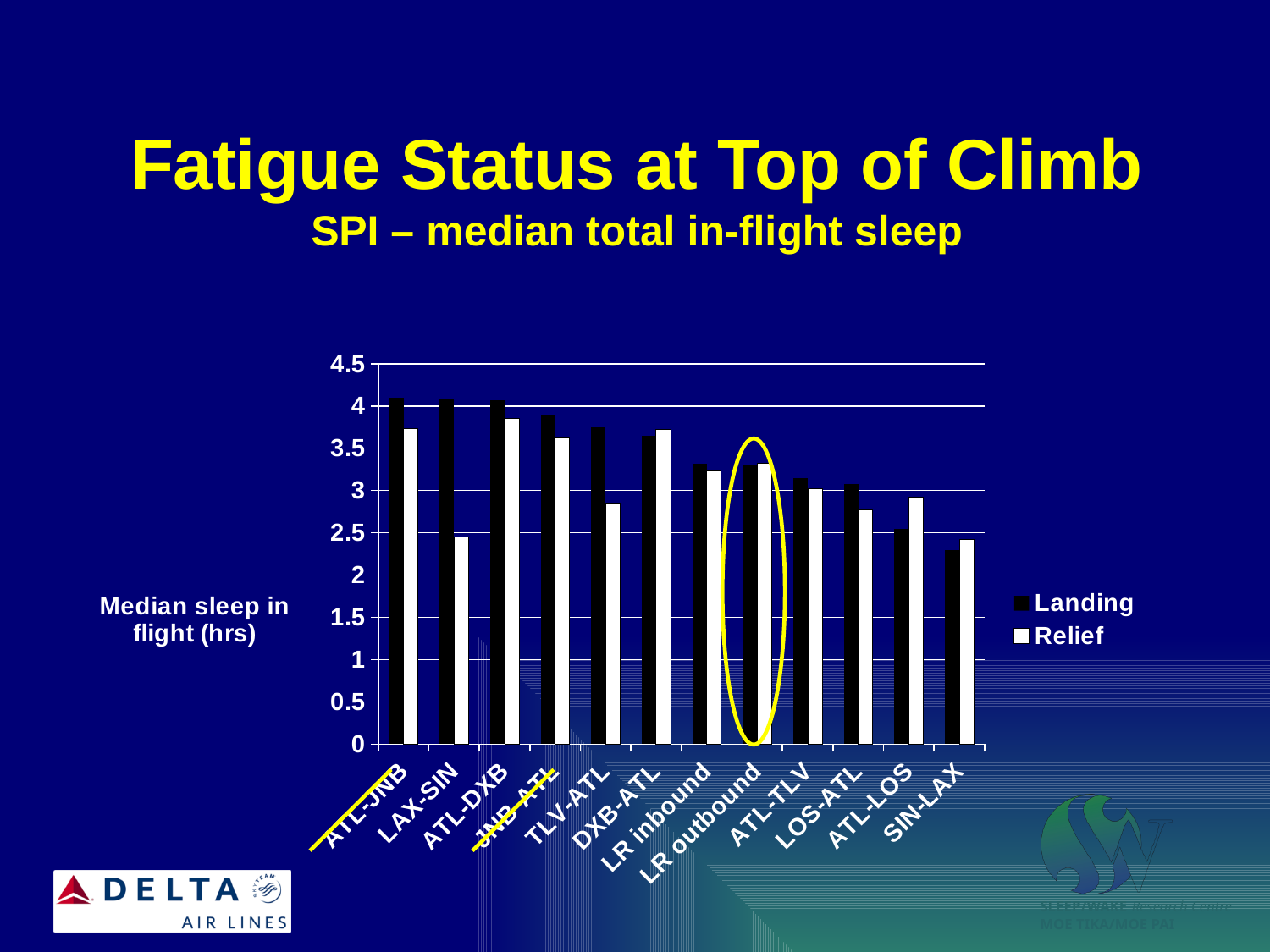
Do the Landing values generally rise or fall from left to right across the x axis? fall What is the label on the y axis of the chart? Median sleep in flight (hrs) Which series is shown with black bars? Landing What kind of chart is shown on the slide? bar chart For LAX-SIN, which is larger, the Landing value or the Relief value? Landing Is the Landing value for ATL-JNB greater or less than 3.5? greater For TLV-ATL, which is larger, the Landing value or the Relief value? Landing Is the Relief value for ATL-DXB greater or less than 3.5? greater Is the Relief value for LAX-SIN greater or less than 3? less How many city-pair categories are shown on the x axis? 12 How many series does the legend list? 2